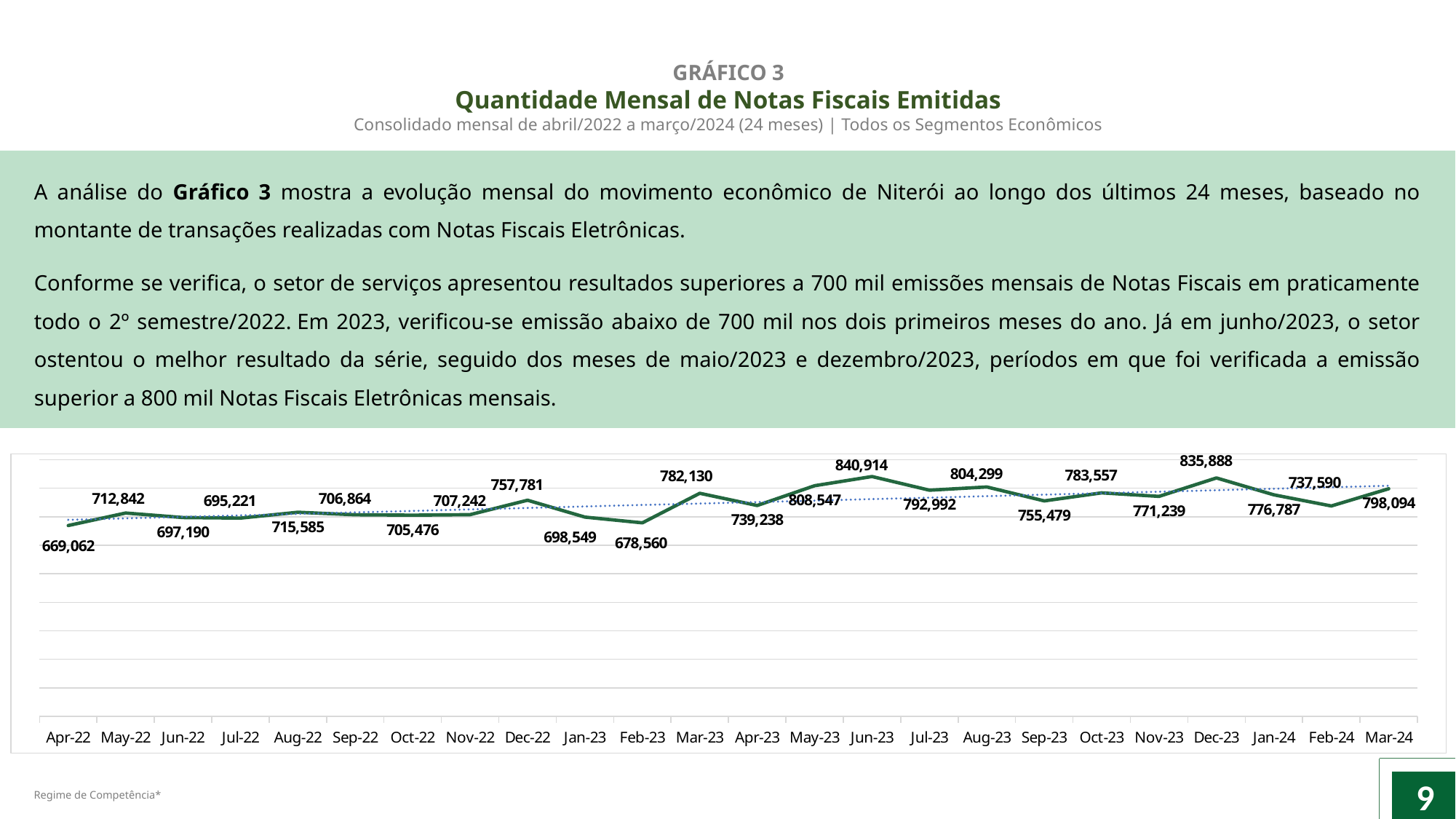
What is the difference between the values for Dec-23 and Nov-23? 64,649 What is the difference between the values for Jun-23 and Apr-22? 171,852 Do the values generally rise or fall from Apr-22 to Mar-24? Rise What is the value for Apr-22? 669,062 What is the value for Jun-23? 840,914 What is the value for Dec-23? 835,888 What is the value for Feb-23? 678,560 Which month has the highest value? Jun-23 Which is larger, the value for Mar-23 or the value for Apr-23? Mar-23 How many months are plotted on the chart? 24 What kind of chart is shown on the slide? Line chart Which month has the lowest value? Apr-22